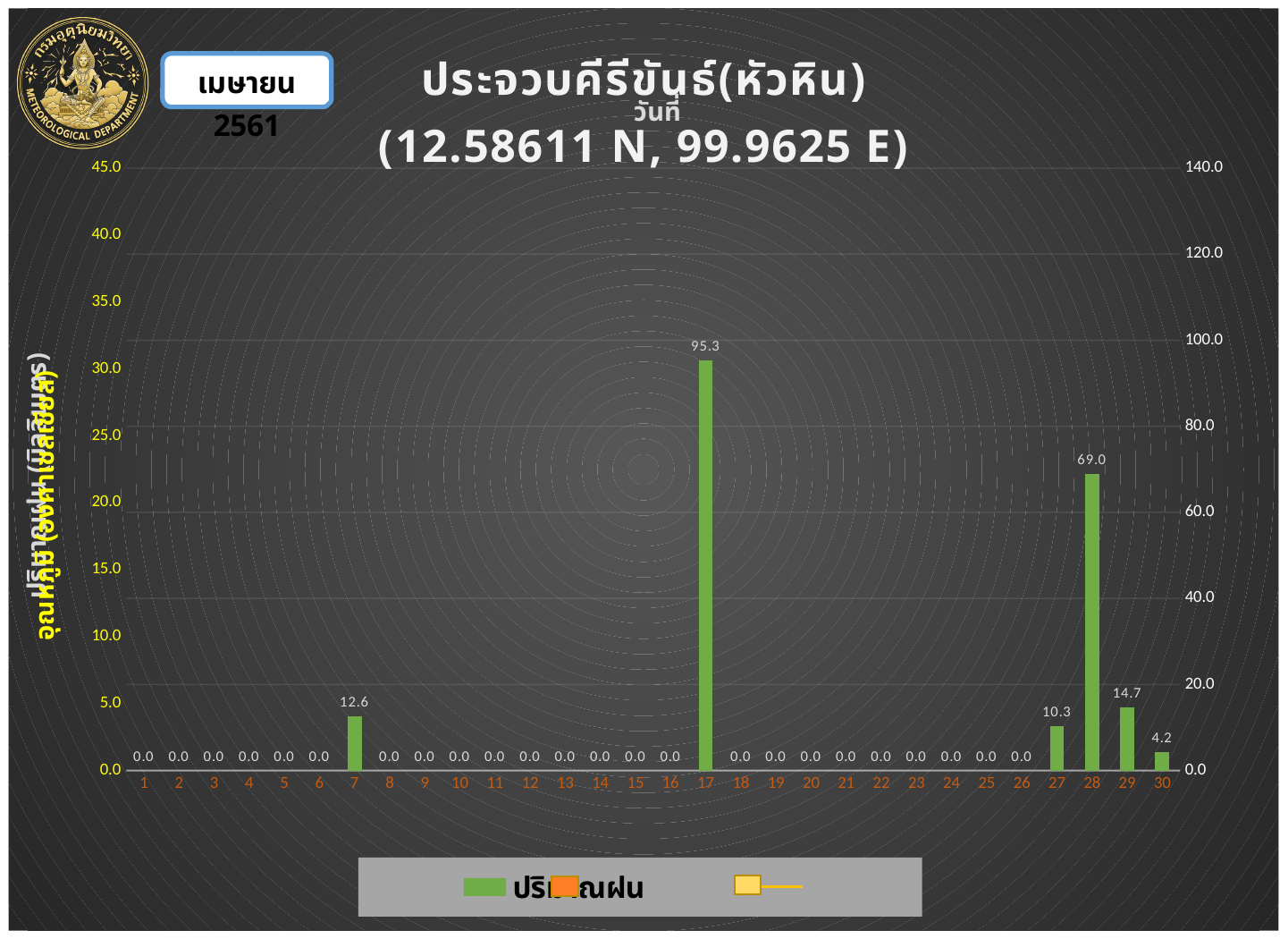
Which has a larger rainfall value, day 27 or day 29? Day 29 What is the rainfall value shown for day 28? 69.0 What kind of chart is shown on the slide? Bar chart Is the rainfall value for day 28 greater or less than 60.0 on the right axis? greater What is the difference between the rainfall values for day 17 and day 28? 26.3 How many days are shown on the x axis? 30 What is the rainfall value shown for day 7? 12.6 What coordinates are given in the chart title? 12.58611 N, 99.9625 E What is the rainfall value shown for day 30? 4.2 What is the rainfall value shown for day 29? 14.7 What is the rainfall value shown for day 17? 95.3 Which day has the highest rainfall value? 17